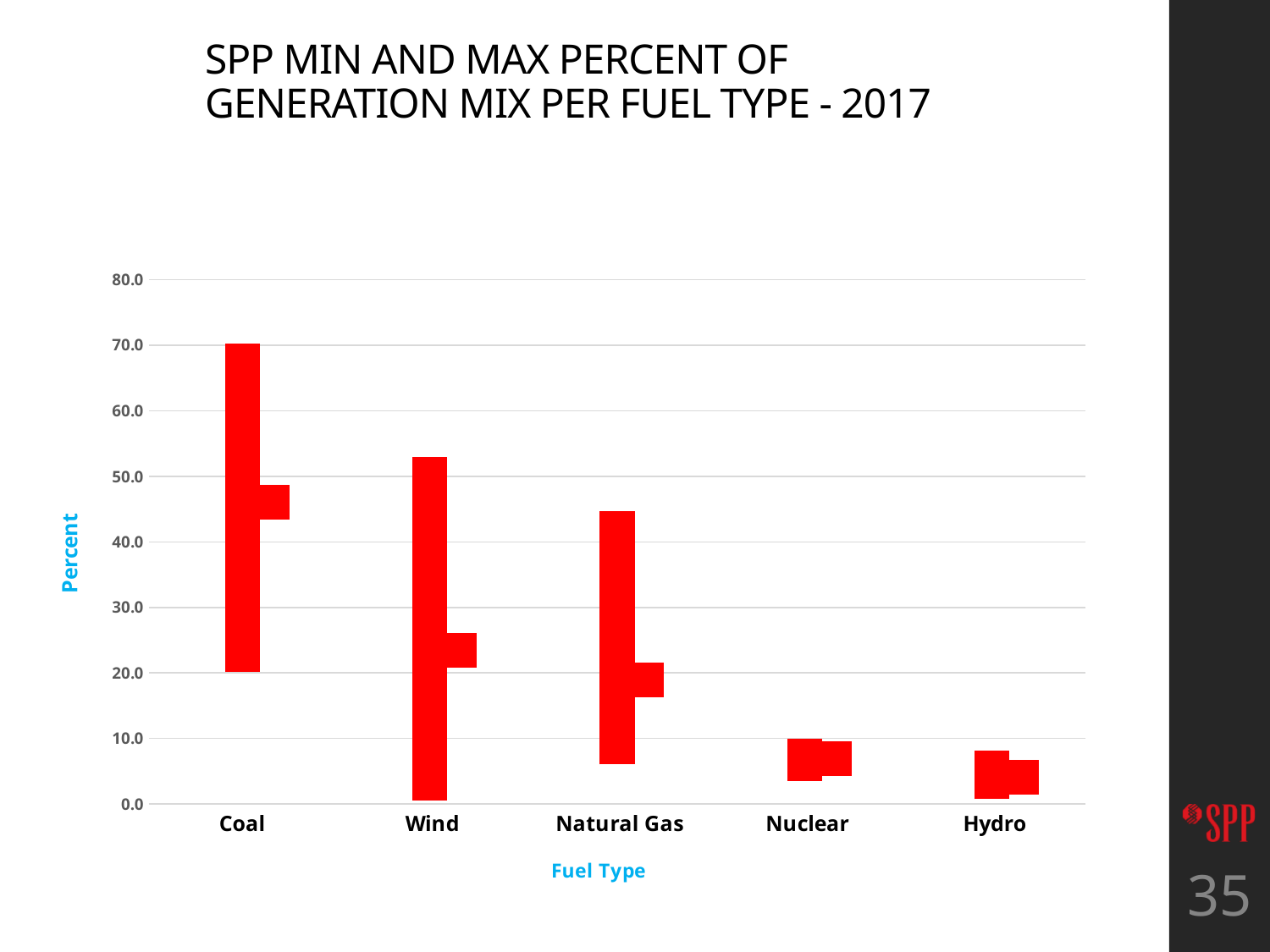
Is the maximum value for Natural Gas greater or less than 50? less Which fuel type has the lowest minimum percent of generation mix? Wind Is the maximum value for Wind greater or less than 40? greater How many fuel types are shown on the x axis? 5 What kind of chart is shown on the slide? bar chart Is the maximum value for Coal greater or less than 60? greater What is the label on the y axis of the chart? Percent Which fuel type has the highest maximum percent of generation mix? Coal Do the maximum values rise or fall moving from Coal to Hydro along the x axis? fall Which has a larger maximum value, Wind or Natural Gas? Wind